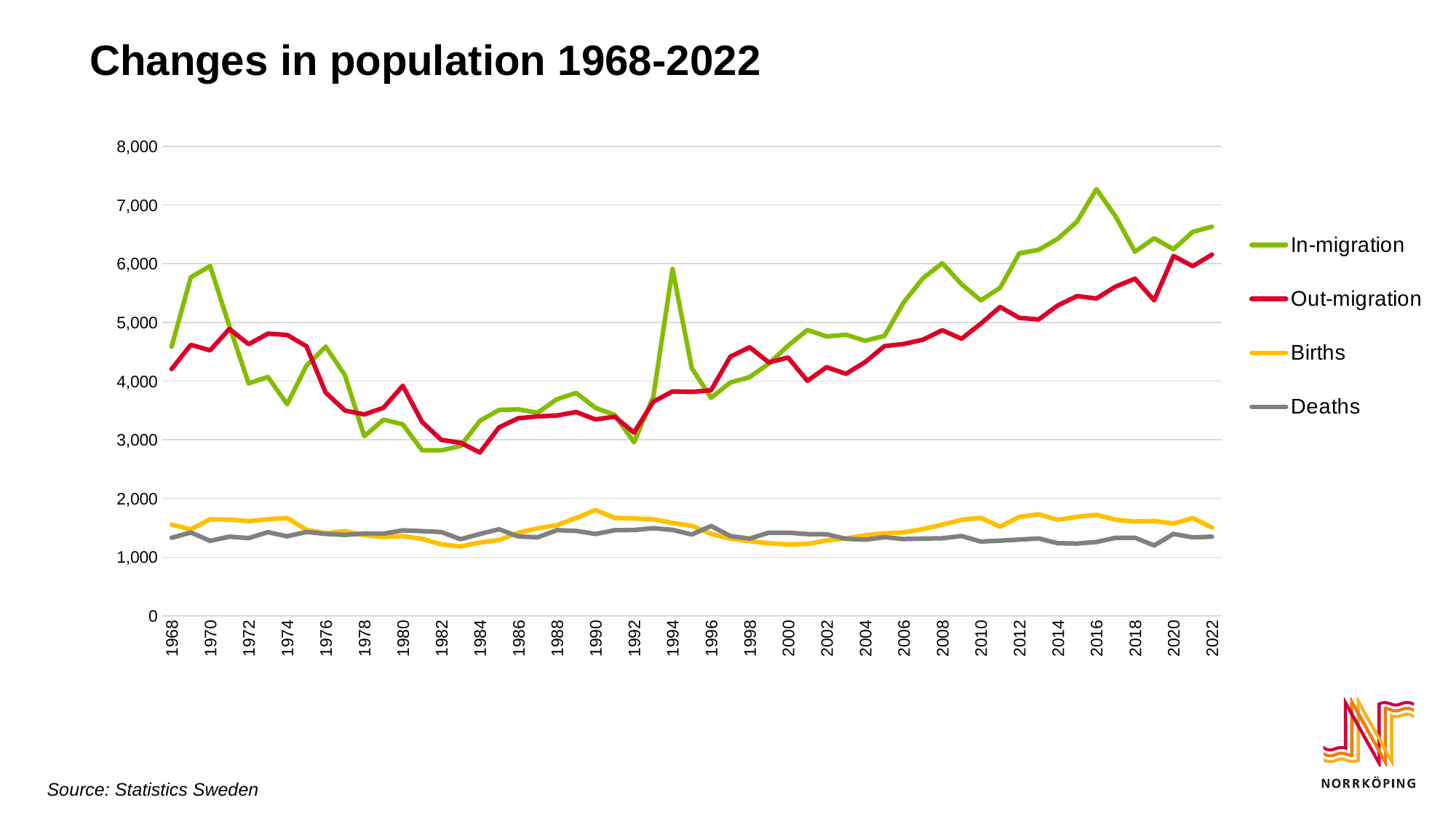
Is the value for In-migration in 1981 greater or less than 3,000? less What source is cited for the chart? Statistics Sweden Is the value for Births in 1990 greater or less than 2,000? less How many series does the legend list? 4 In 1978, which is larger: In-migration or Out-migration? Out-migration What is the title of the chart? Changes in population 1968-2022 Is the value for In-migration in 2016 greater or less than 7,000? greater Which series has the highest value in 2022? In-migration In 2022, which is larger: In-migration or Out-migration? In-migration In 1994, which is larger: In-migration or Out-migration? In-migration What kind of chart is shown on the slide? line chart